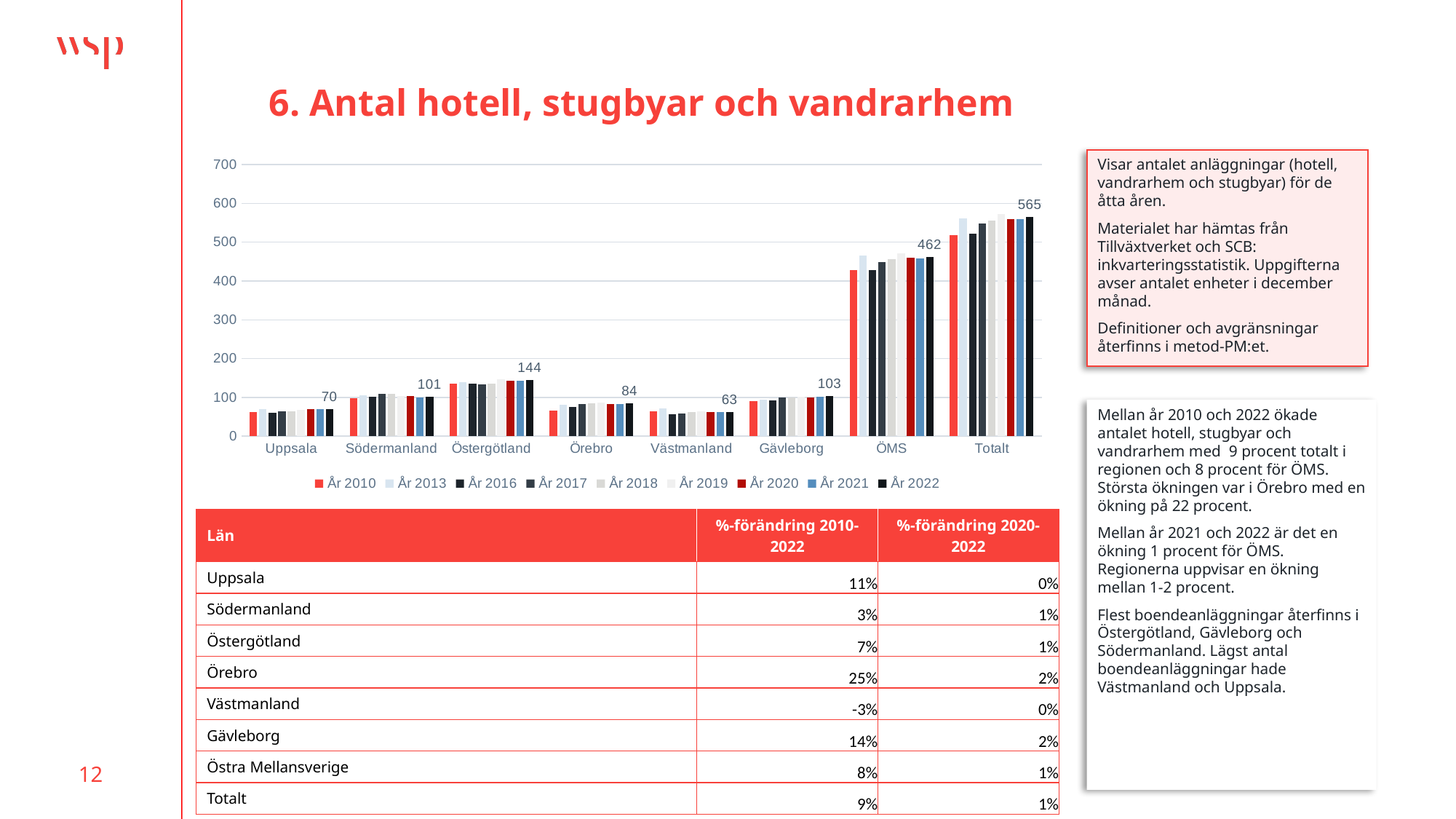
What is the value for Totalt in the År 2022 series? 565 How many categories are shown on the x axis of the chart? 8 What is the value for Uppsala in the År 2022 series? 70 What is the value for ÖMS in the År 2022 series? 462 Is the value for Totalt in the År 2010 series greater or less than 400? greater What is the value for Östergötland in the År 2022 series? 144 What is the difference between the År 2022 values for Östergötland and Uppsala? 74 Among the six counties (excluding ÖMS and Totalt), which has the lowest År 2022 value? Västmanland How many series does the chart legend list? 9 Among the six counties (excluding ÖMS and Totalt), which has the highest År 2022 value? Östergötland What kind of chart is shown on the slide? Bar chart Which has the larger År 2022 value, Gävleborg or Södermanland? Gävleborg